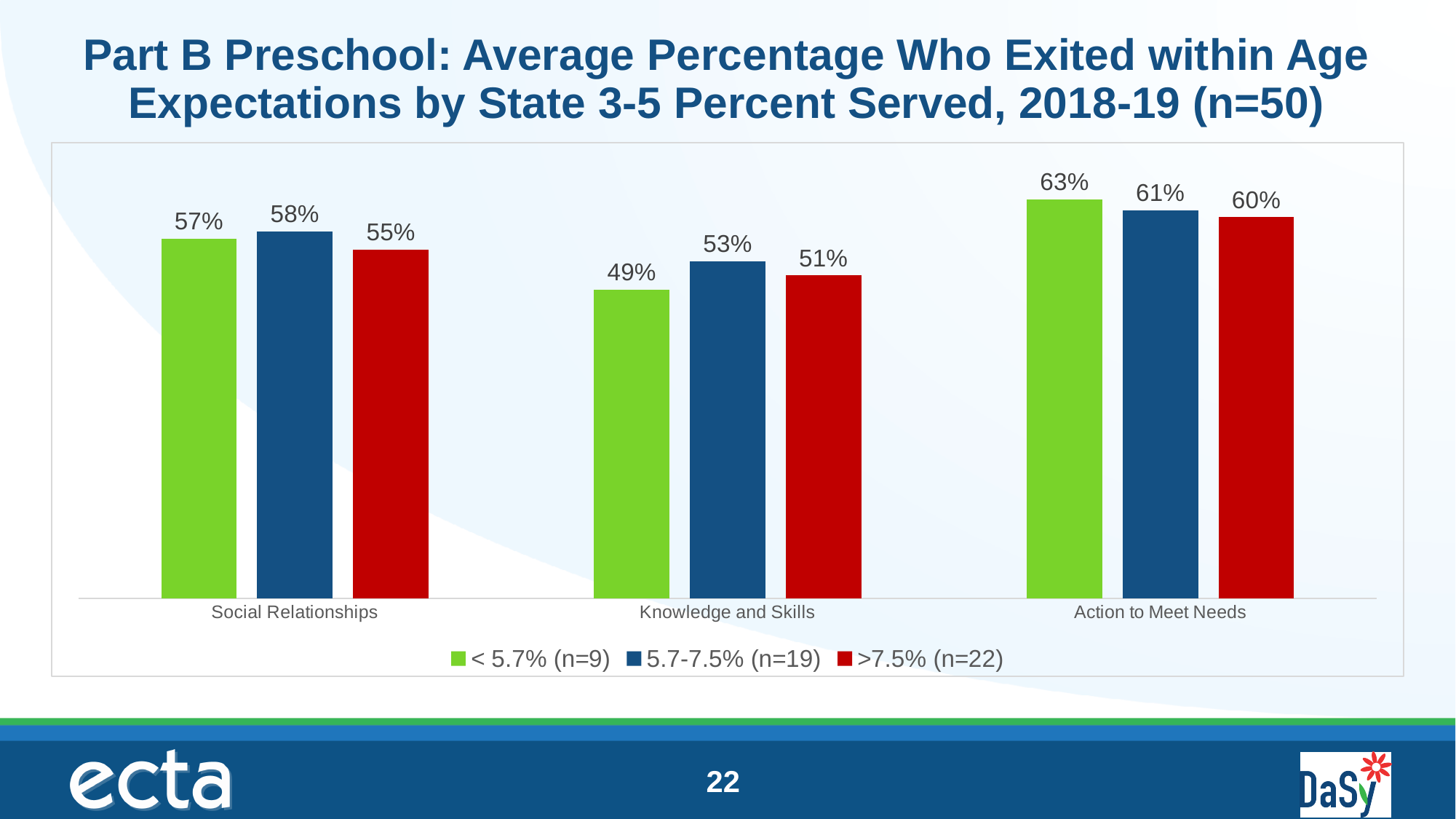
Which category has the highest value for the < 5.7% (n=9) series? Action to Meet Needs What kind of chart is shown on the slide? Bar chart What is the value for the >7.5% (n=22) series in the Knowledge and Skills category? 51% Which colour represents the >7.5% (n=22) series? Red How many categories are shown on the x axis? 3 Which category has the lowest value for the 5.7-7.5% (n=19) series? Knowledge and Skills What is the value for the 5.7-7.5% (n=19) series in the Action to Meet Needs category? 61% In the Social Relationships category, which is larger: the 5.7-7.5% (n=19) value or the >7.5% (n=22) value? 5.7-7.5% (n=19) What is the difference between the < 5.7% (n=9) value and the >7.5% (n=22) value in the Knowledge and Skills category? 2% What is the difference between the Action to Meet Needs and Social Relationships values for the >7.5% (n=22) series? 5% How many series does the legend list? 3 What is the value for the < 5.7% (n=9) series in the Social Relationships category? 57%